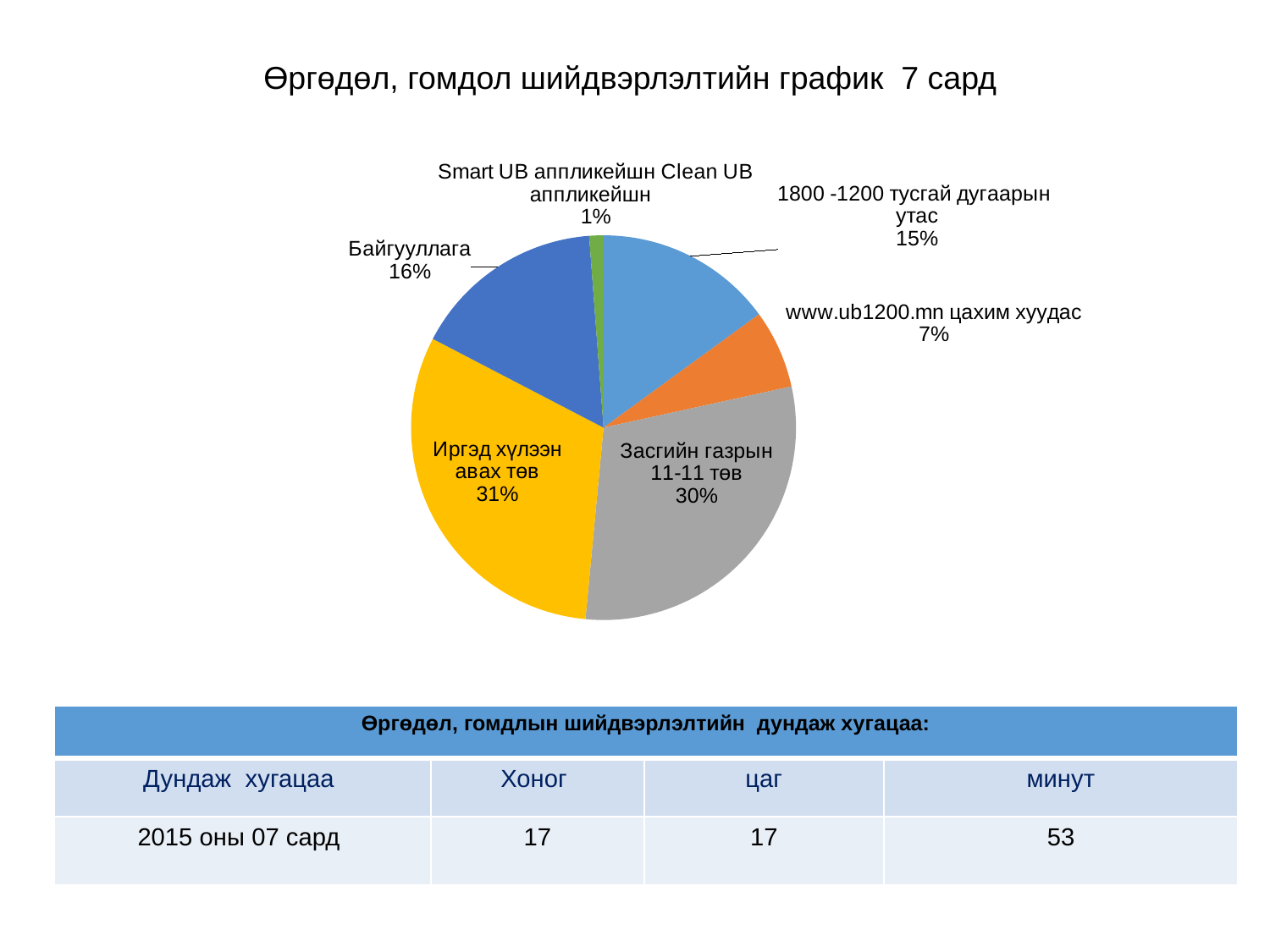
Which is larger: the share for "1800 -1200 тусгай дугаарын утас" or the share for "Байгууллага"? Байгууллага Which category has the smallest share of the pie? Smart UB аппликейшн Clean UB аппликейшн What percentage is shown for "Байгууллага"? 16% Which category has the largest share of the pie? Иргэд хүлээн авах төв What is the difference in percentage points between "Байгууллага" and "www.ub1200.mn цахим хуудас"? 9% What percentage is shown for "www.ub1200.mn цахим хуудас"? 7% How many slices does the pie chart have? 6 What percentage is shown for "1800 -1200 тусгай дугаарын утас"? 15% What kind of chart is shown on the slide? Pie chart What share of the pie does "Иргэд хүлээн авах төв" have? 31% What percentage is shown for "Smart UB аппликейшн Clean UB аппликейшн"? 1% What share of the pie does "Засгийн газрын 11-11 төв" have? 30%